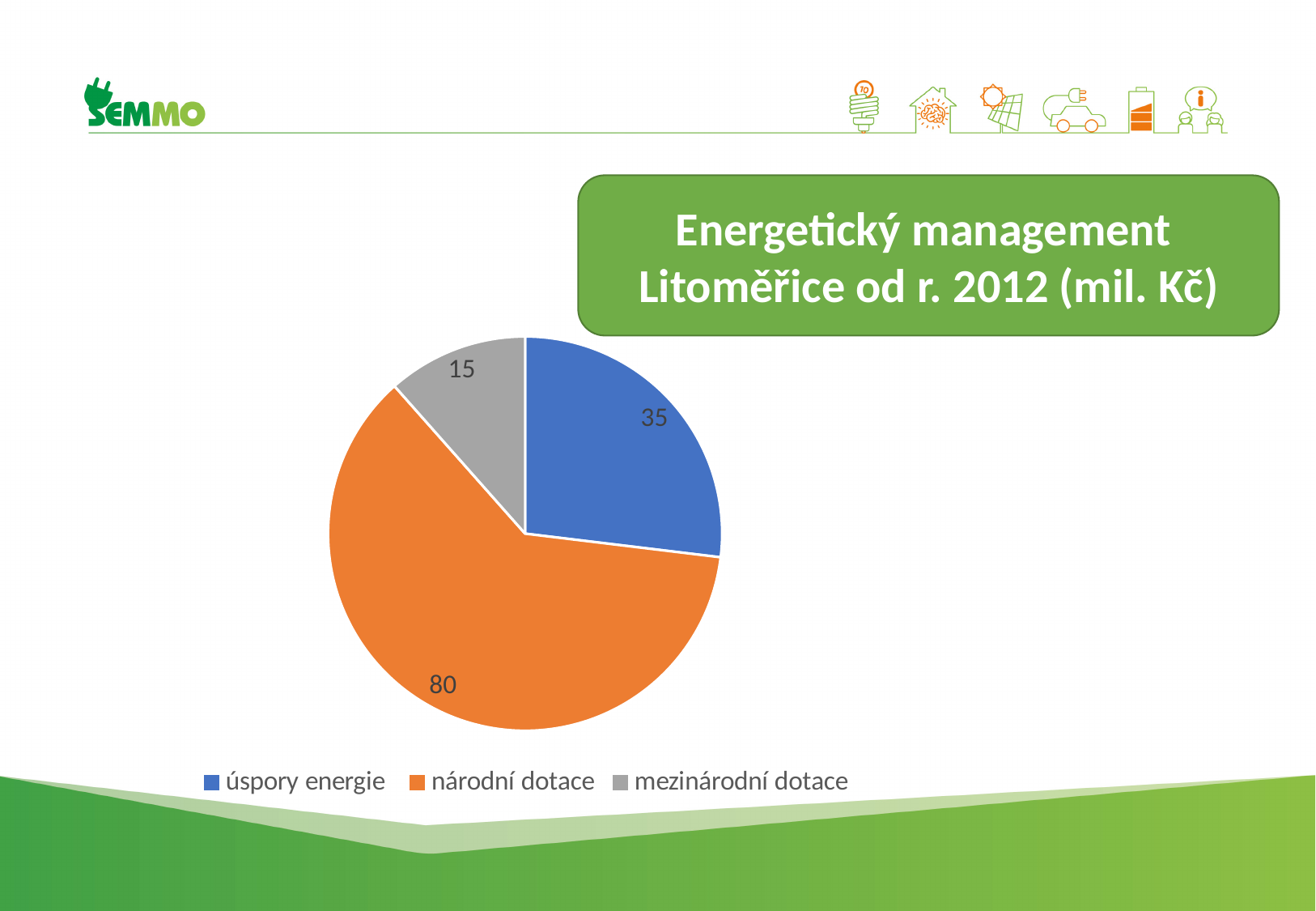
What is the difference between the values for národní dotace and úspory energie? 45 What is the value for národní dotace? 80 How many categories does the pie chart show? 3 What is the value for úspory energie? 35 Which is larger, úspory energie or mezinárodní dotace? úspory energie What is the total of all slices in the pie chart? 130 What is the value for mezinárodní dotace? 15 Which colour represents národní dotace in the legend? orange What is the difference between the values for úspory energie and mezinárodní dotace? 20 Which category has the largest slice of the pie? národní dotace What kind of chart is shown on the slide? pie chart Which category has the smallest slice of the pie? mezinárodní dotace